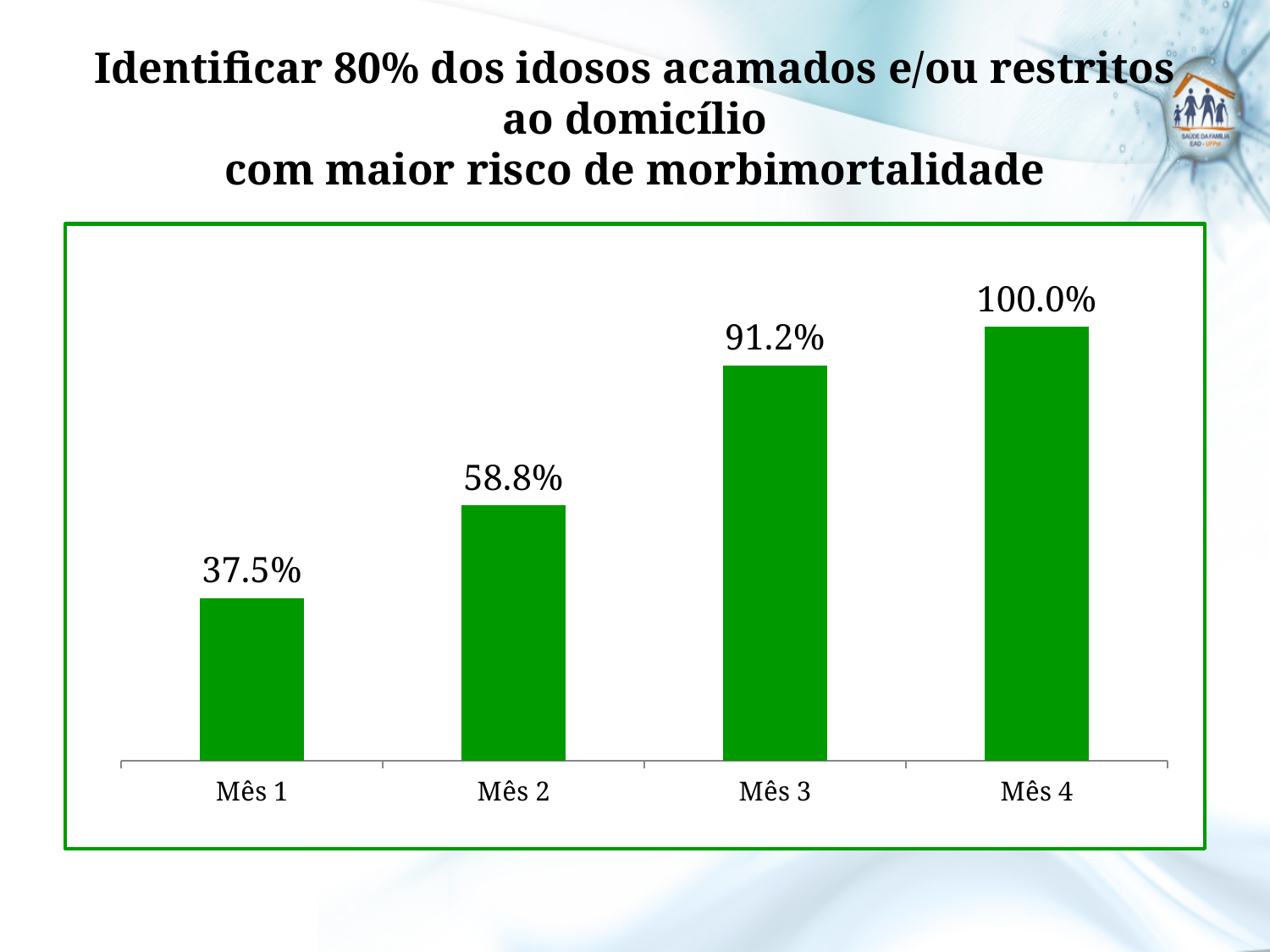
What is the difference between the values for Mês 2 and Mês 1? 21.3% What is the value for Mês 2? 58.8% Which month has the highest value? Mês 4 Which month has the lowest value? Mês 1 What is the value for Mês 1? 37.5% What is the value for Mês 3? 91.2% What kind of chart is shown on the slide? Bar chart Do the values rise or fall from Mês 1 to Mês 4? Rise What is the difference between the values for Mês 4 and Mês 3? 8.8% What is the value for Mês 4? 100.0% Which is larger, the value for Mês 2 or the value for Mês 3? Mês 3 How many months are shown on the x axis? 4